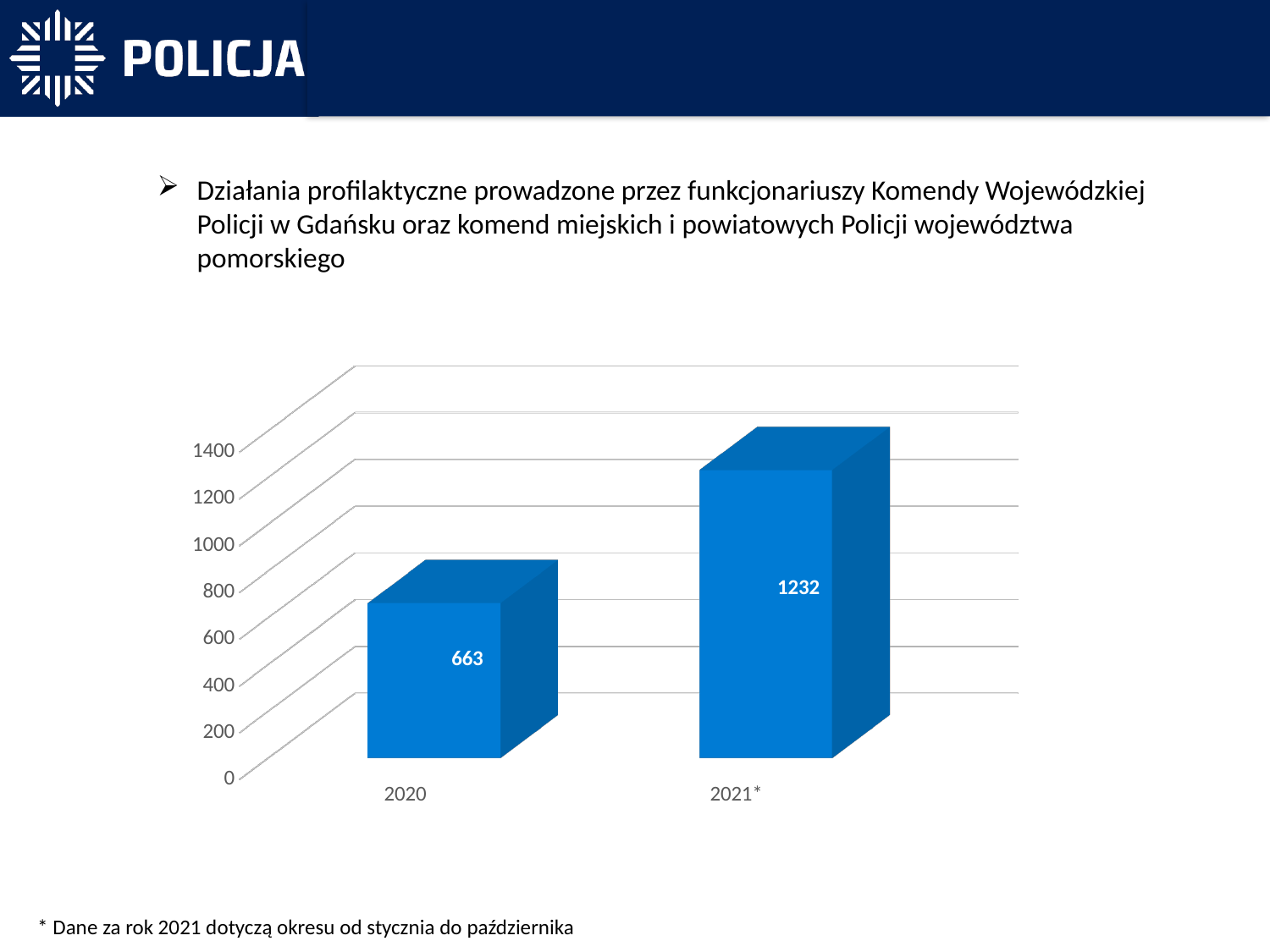
Do the values rise or fall from 2020 to 2021*? rise Is the value for 2021* greater or less than 1000? greater Is the value for 2020 greater or less than 800? less Which is larger, the value for 2020 or the value for 2021*? 2021* What is the difference between the values for 2021* and 2020? 569 Which year has the lowest value? 2020 What kind of chart is shown on the slide? bar chart What is the value for 2021*? 1232 What is the highest tick value shown on the vertical axis? 1400 What is the value for 2020? 663 Which year has the highest value? 2021* How many categories are shown on the x axis? 2